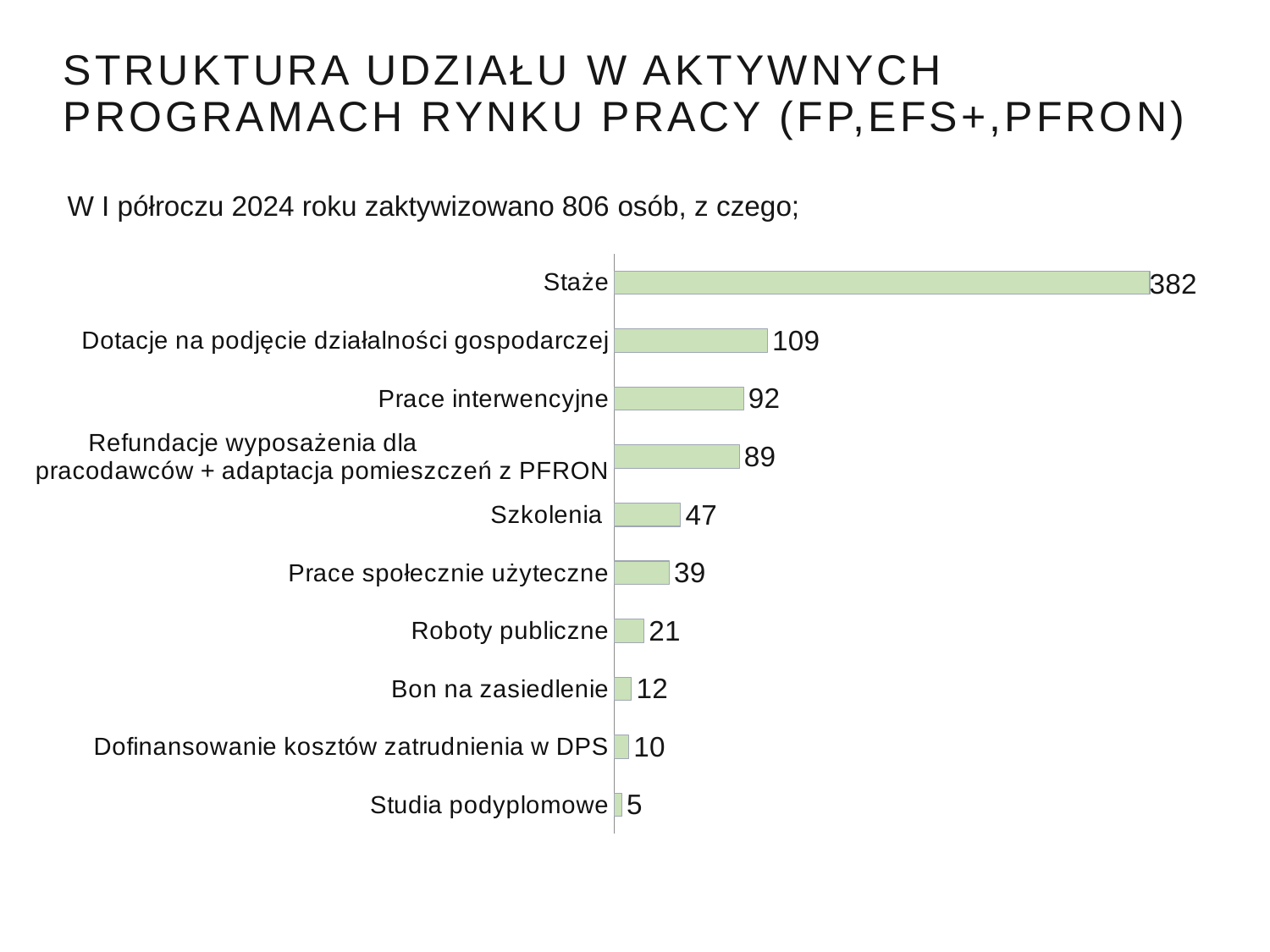
What is the value for Szkolenia? 47 How many categories are shown in the chart? 10 What kind of chart is shown on the slide? Bar chart What is the difference between the values for Staże and Dotacje na podjęcie działalności gospodarczej? 273 What is the value for Bon na zasiedlenie? 12 What is the difference between the values for Prace interwencyjne and Szkolenia? 45 According to the text above the chart, how many people were activated in the first half of 2024? 806 Which is larger, the value for Roboty publiczne or the value for Prace społecznie użyteczne? Prace społecznie użyteczne What is the value for Dotacje na podjęcie działalności gospodarczej? 109 Which category has the lowest value? Studia podyplomowe What is the value for Staże? 382 Which category has the highest value? Staże